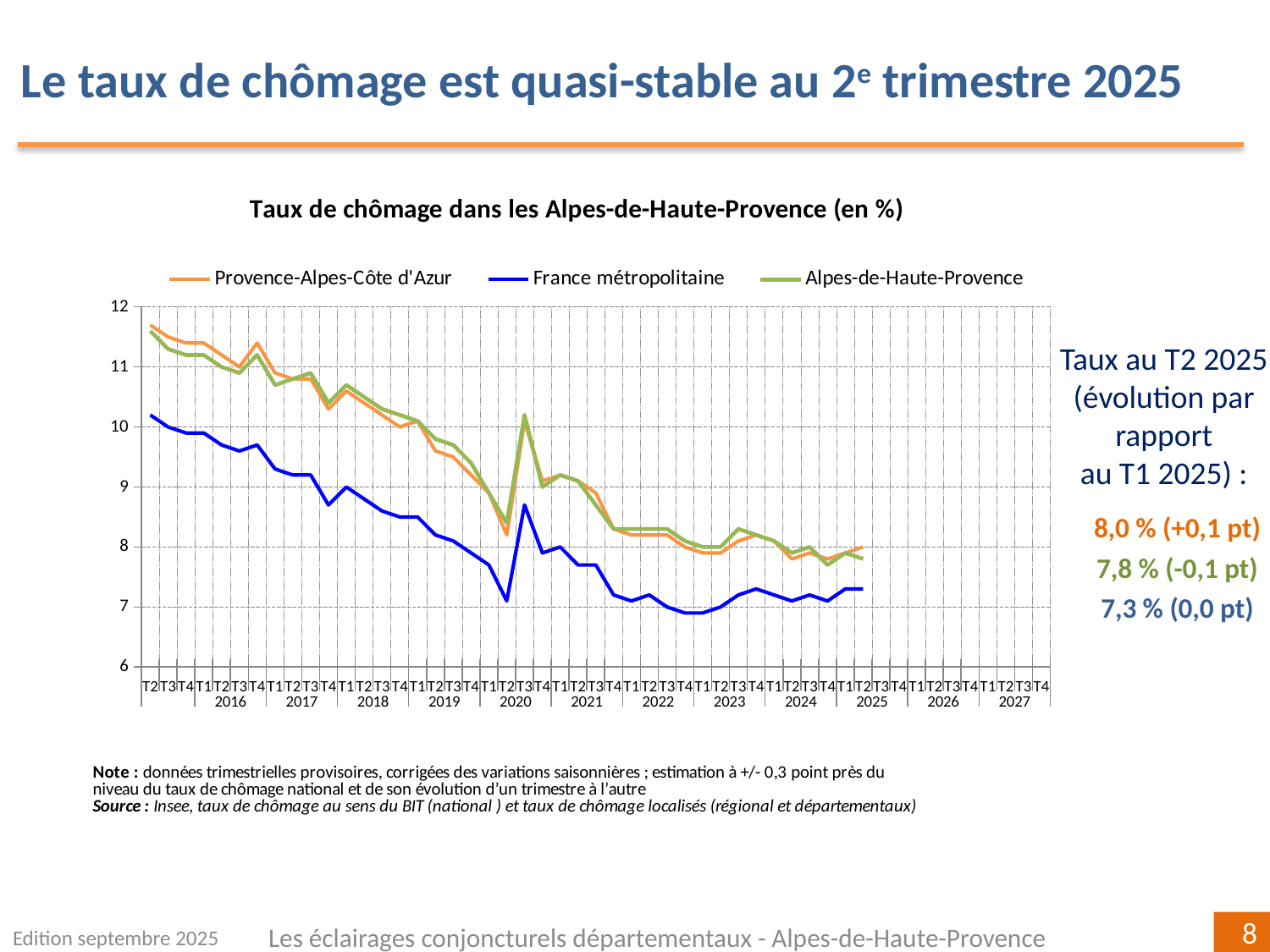
At T2 2025, which is higher: Provence-Alpes-Côte d'Azur or France métropolitaine? Provence-Alpes-Côte d'Azur Overall, do the unemployment rates rise or fall from 2016 to 2025? fall What is the unemployment rate for Alpes-de-Haute-Provence at T2 2025? 7,8 % Which series has the lowest value at T2 2025? France métropolitaine What is the change in the Alpes-de-Haute-Provence rate between T1 2025 and T2 2025? -0,1 pt What is the unemployment rate for Provence-Alpes-Côte d'Azur at T2 2025? 8,0 % Is the value for Provence-Alpes-Côte d'Azur at the start of the series greater or less than 11? greater What is the unemployment rate for France métropolitaine at T2 2025? 7,3 % What is the title of the chart? Taux de chômage dans les Alpes-de-Haute-Provence (en %) What is the difference between the Provence-Alpes-Côte d'Azur rate and the France métropolitaine rate at T2 2025? 0,7 How many series does the legend list? 3 What kind of chart is shown on the slide? line chart